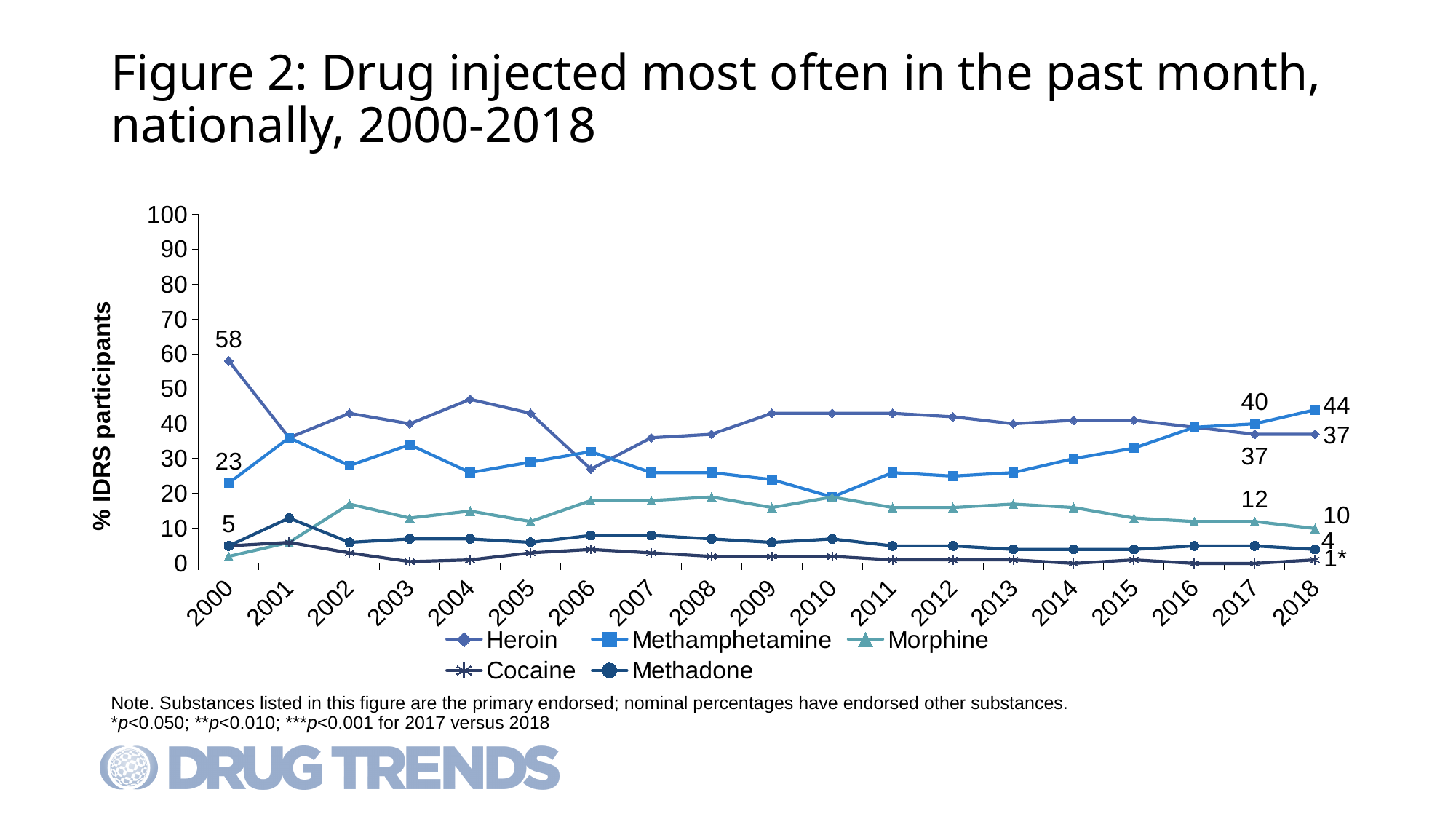
What was the value for Methadone in 2018? 4 Is the value for Heroin in 2004 greater or less than 40? greater What kind of chart is shown on the slide? line chart In 2018, which is larger: Methamphetamine or Heroin? Methamphetamine What was the value for Morphine in 2018? 10 What was the value for Heroin in 2000? 58 What was the value for Methamphetamine in 2018? 44 How many years are shown on the x axis? 19 What was the value for Methamphetamine in 2000? 23 By how much did the Heroin value fall from 2000 to 2018? 21 How many series does the legend list? 5 Which series had the highest value in 2000? Heroin